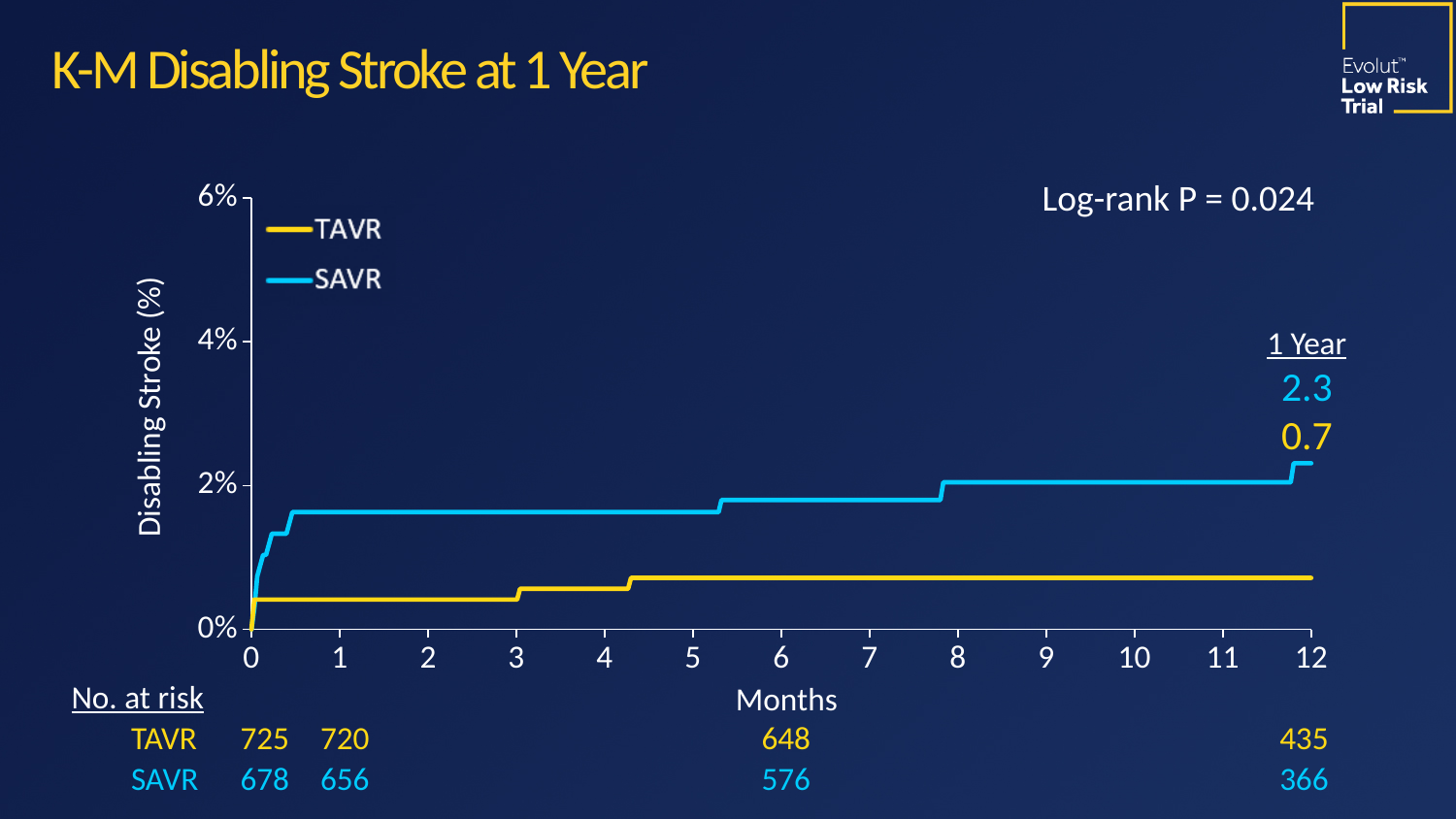
What is the 1-year disabling stroke rate for TAVR? 0.7 Which group has the higher disabling stroke rate at 1 year, TAVR or SAVR? SAVR How many series does the legend list? 2 What is the log-rank P value shown on the chart? 0.024 What is the 1-year disabling stroke rate for SAVR? 2.3 Is the SAVR curve at 12 months greater or less than 2%? greater Is the TAVR curve at 12 months greater or less than 2%? less What is the label of the y axis? Disabling Stroke (%) What is the difference between the SAVR and TAVR disabling stroke rates at 1 year? 1.6 What is the number at risk for TAVR at 12 months? 435 What is the number at risk for SAVR at month 0? 678 Do the disabling stroke curves rise or fall over the months shown? rise